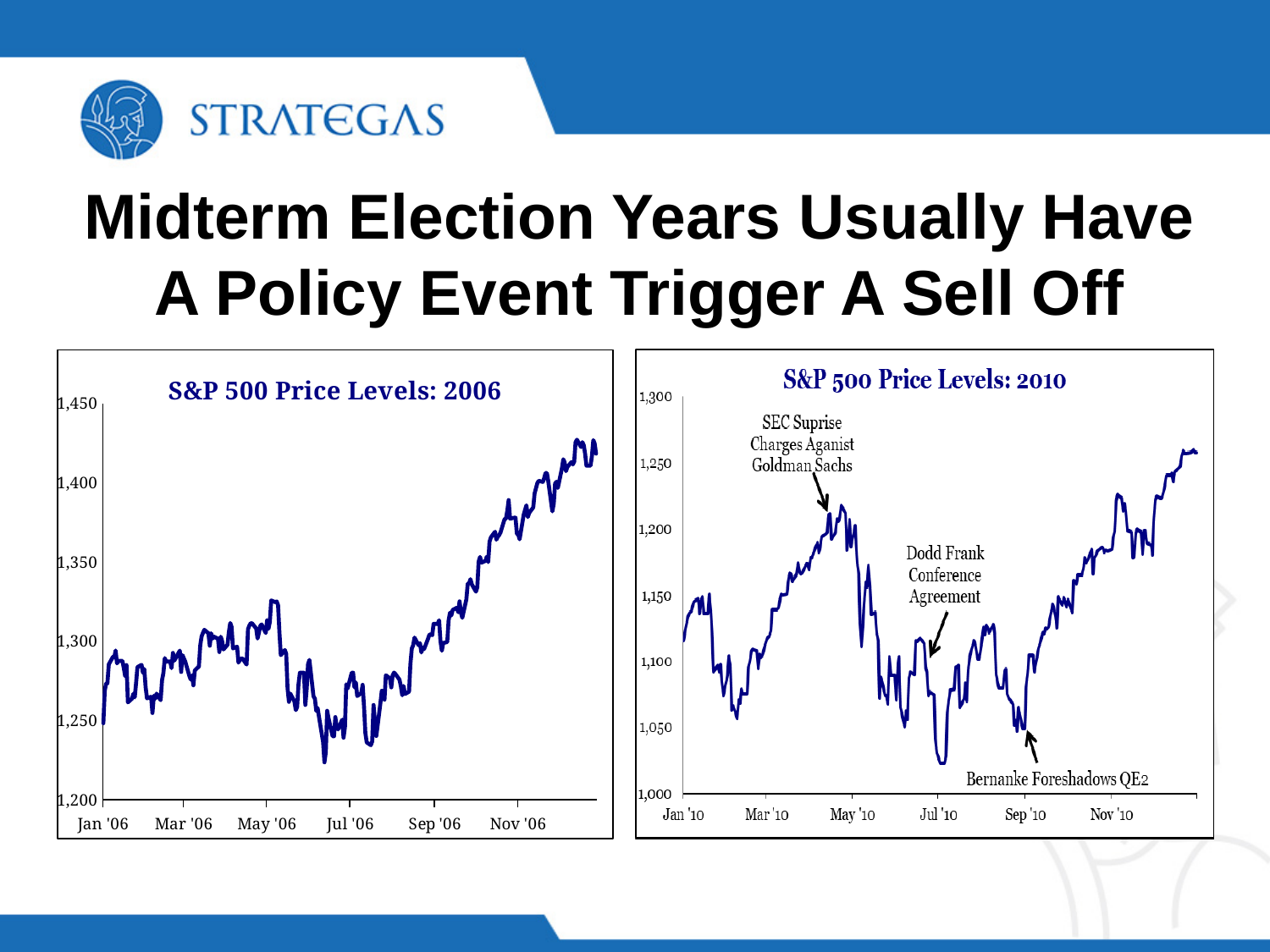
In the 'S&P 500 Price Levels: 2006' chart, is the value at the end of Nov '06 greater or less than 1,350? greater In the 'S&P 500 Price Levels: 2006' chart, is the value at Jan '06 greater or less than 1,300? less In the 'S&P 500 Price Levels: 2010' chart, is the value at Jul '10 greater or less than 1,100? less In the 'S&P 500 Price Levels: 2006' chart, is the level higher at the start of the year or at the end of the year? end of the year Which two years are compared by the two charts on the slide? 2006 and 2010 What type of chart is the 'S&P 500 Price Levels: 2006' chart on the left? line chart In the 'S&P 500 Price Levels: 2010' chart, is the level higher at Jan '10 or at the end of the series in December? end of the series in December In the 'S&P 500 Price Levels: 2010' chart, which event is annotated near the low point around Sep '10? Bernanke Foreshadows QE2 In the 'S&P 500 Price Levels: 2006' chart, does the S&P 500 level rise or fall overall from Jan '06 to the end of the year? rise